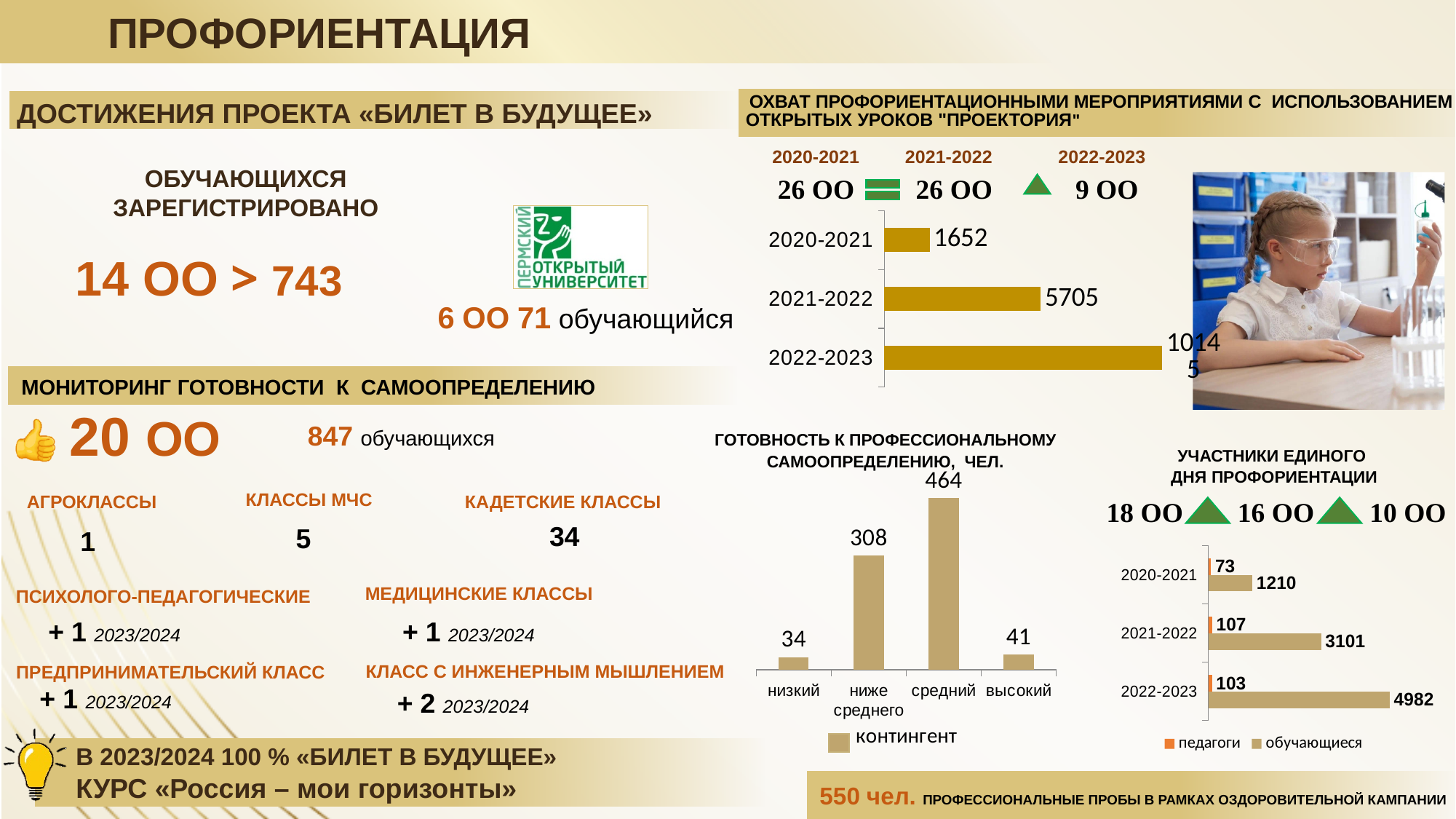
In the chart "ГОТОВНОСТЬ К ПРОФЕССИОНАЛЬНОМУ САМООПРЕДЕЛЕНИЮ, ЧЕЛ.", what is the value for "средний"? 464 What is the legend entry of the chart "ГОТОВНОСТЬ К ПРОФЕССИОНАЛЬНОМУ САМООПРЕДЕЛЕНИЮ, ЧЕЛ."? контингент What kind of chart is "УЧАСТНИКИ ЕДИНОГО ДНЯ ПРОФОРИЕНТАЦИИ"? bar chart How many series does the legend of the chart "УЧАСТНИКИ ЕДИНОГО ДНЯ ПРОФОРИЕНТАЦИИ" list? 2 In the chart "ОХВАТ ПРОФОРИЕНТАЦИОННЫМИ МЕРОПРИЯТИЯМИ С ИСПОЛЬЗОВАНИЕМ ОТКРЫТЫХ УРОКОВ "ПРОЕКТОРИЯ"", do the values rise or fall from 2020-2021 to 2022-2023? rise In the chart "ОХВАТ ПРОФОРИЕНТАЦИОННЫМИ МЕРОПРИЯТИЯМИ С ИСПОЛЬЗОВАНИЕМ ОТКРЫТЫХ УРОКОВ "ПРОЕКТОРИЯ"", which period has the highest value? 2022-2023 In the chart "УЧАСТНИКИ ЕДИНОГО ДНЯ ПРОФОРИЕНТАЦИИ", what is the value for "обучающиеся" in 2021-2022? 3101 In the chart "ОХВАТ ПРОФОРИЕНТАЦИОННЫМИ МЕРОПРИЯТИЯМИ С ИСПОЛЬЗОВАНИЕМ ОТКРЫТЫХ УРОКОВ "ПРОЕКТОРИЯ"", what is the value for 2021-2022? 5705 In the chart "УЧАСТНИКИ ЕДИНОГО ДНЯ ПРОФОРИЕНТАЦИИ", which period has the highest value for "педагоги"? 2021-2022 In the chart "ГОТОВНОСТЬ К ПРОФЕССИОНАЛЬНОМУ САМООПРЕДЕЛЕНИЮ, ЧЕЛ.", which category has the lowest value? низкий In the chart "ГОТОВНОСТЬ К ПРОФЕССИОНАЛЬНОМУ САМООПРЕДЕЛЕНИЮ, ЧЕЛ.", what is the difference between "средний" and "ниже среднего"? 156 How many categories are shown in the chart "ГОТОВНОСТЬ К ПРОФЕССИОНАЛЬНОМУ САМООПРЕДЕЛЕНИЮ, ЧЕЛ."? 4